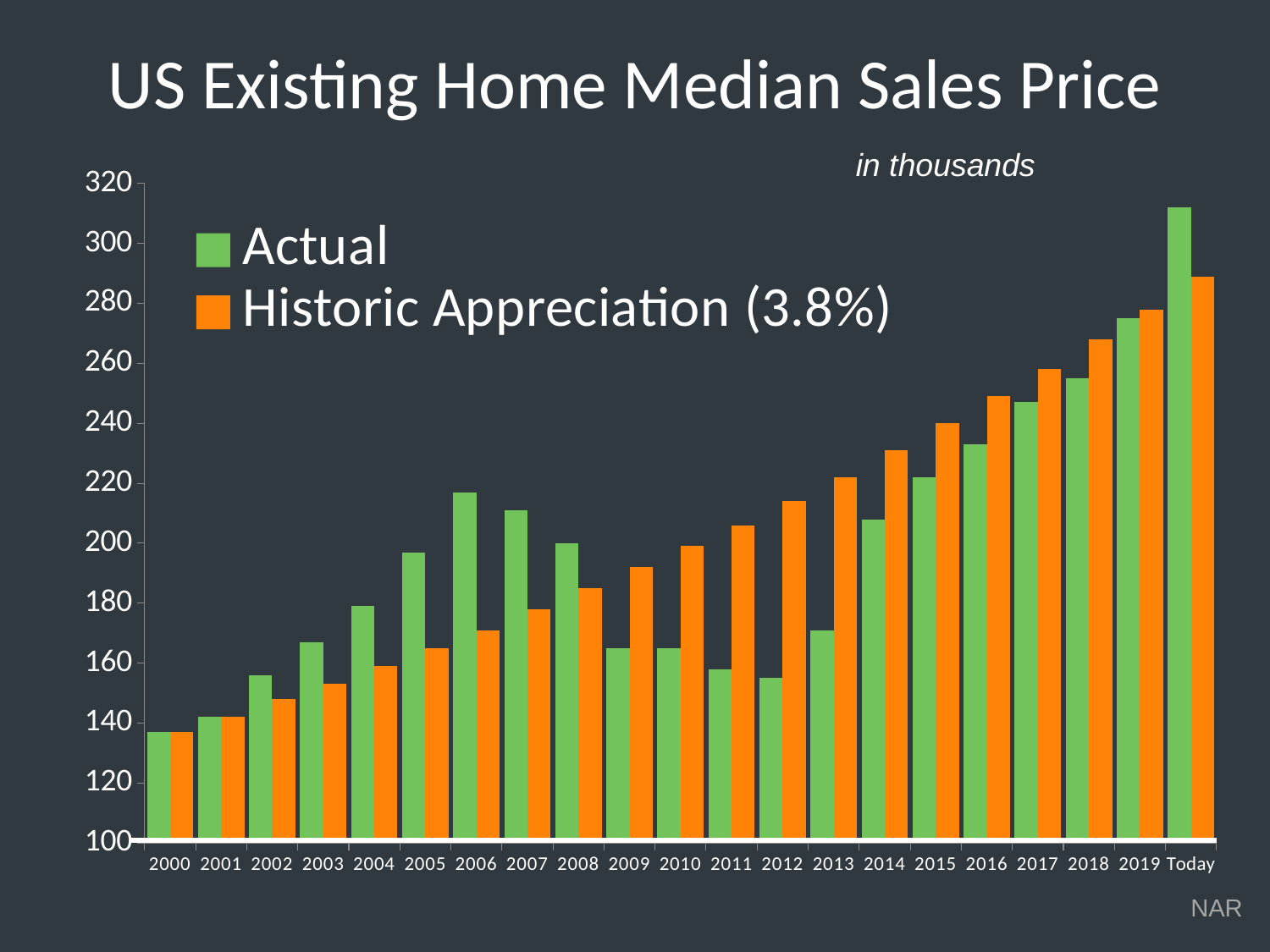
Is the Actual value for 2012 greater or less than 160? less What kind of chart is shown on the slide? bar chart Is the Historic Appreciation (3.8%) value for 2012 greater or less than 200? greater Which category has the highest Actual value? Today Which category has the highest Historic Appreciation (3.8%) value? Today Which category has the lowest Actual value? 2000 In 2012, which is larger: the Actual value or the Historic Appreciation (3.8%) value? Historic Appreciation (3.8%) Do the Historic Appreciation (3.8%) values rise or fall from 2000 to Today? rise How many series does the legend list? 2 In 2006, which is larger: the Actual value or the Historic Appreciation (3.8%) value? Actual How many categories are shown along the x axis? 21 Is the Actual value for 2006 greater or less than 200? greater